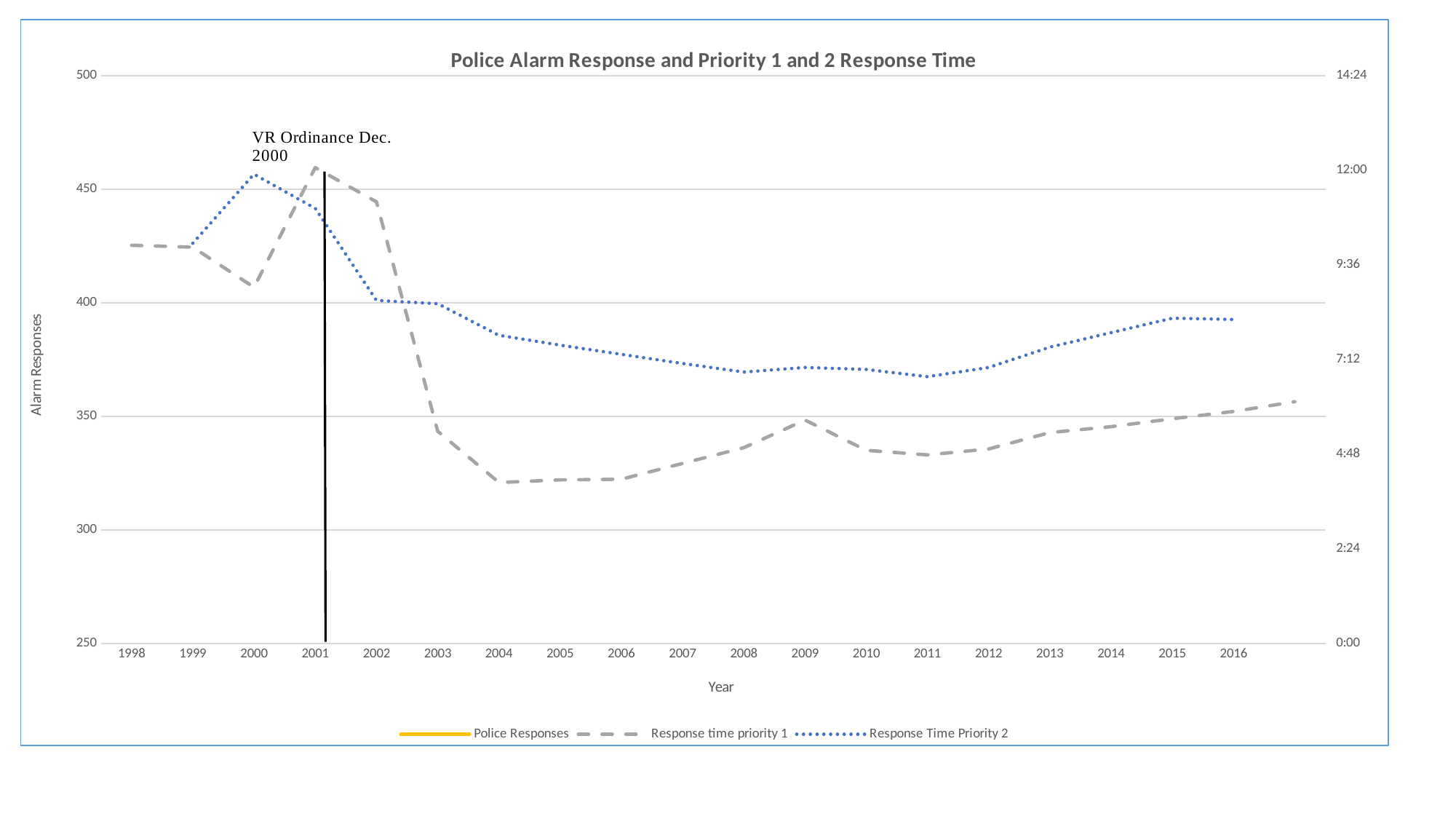
How many series does the legend list? 3 Reading against the right-hand axis, is the Response time priority 1 value for 2004 greater or less than 4:48? less In which year does the Response time priority 1 series reach its highest point? 2001 Does the Response time priority 1 series rise or fall from 2004 to 2016? Rise What is the title of the chart? Police Alarm Response and Priority 1 and 2 Response Time How many years are labeled on the x axis? 19 In 2003, which series is higher: Response time priority 1 or Response Time Priority 2? Response Time Priority 2 What event does the annotation next to the vertical black line mark? VR Ordinance Dec. 2000 What type of chart is shown on the slide? Line chart Reading against the right-hand axis, is the Response Time Priority 2 value for 2016 greater or less than 9:36? less In which year does the Response Time Priority 2 series reach its highest point? 2000 Does the Response Time Priority 2 series rise or fall from 2000 to 2011? Fall